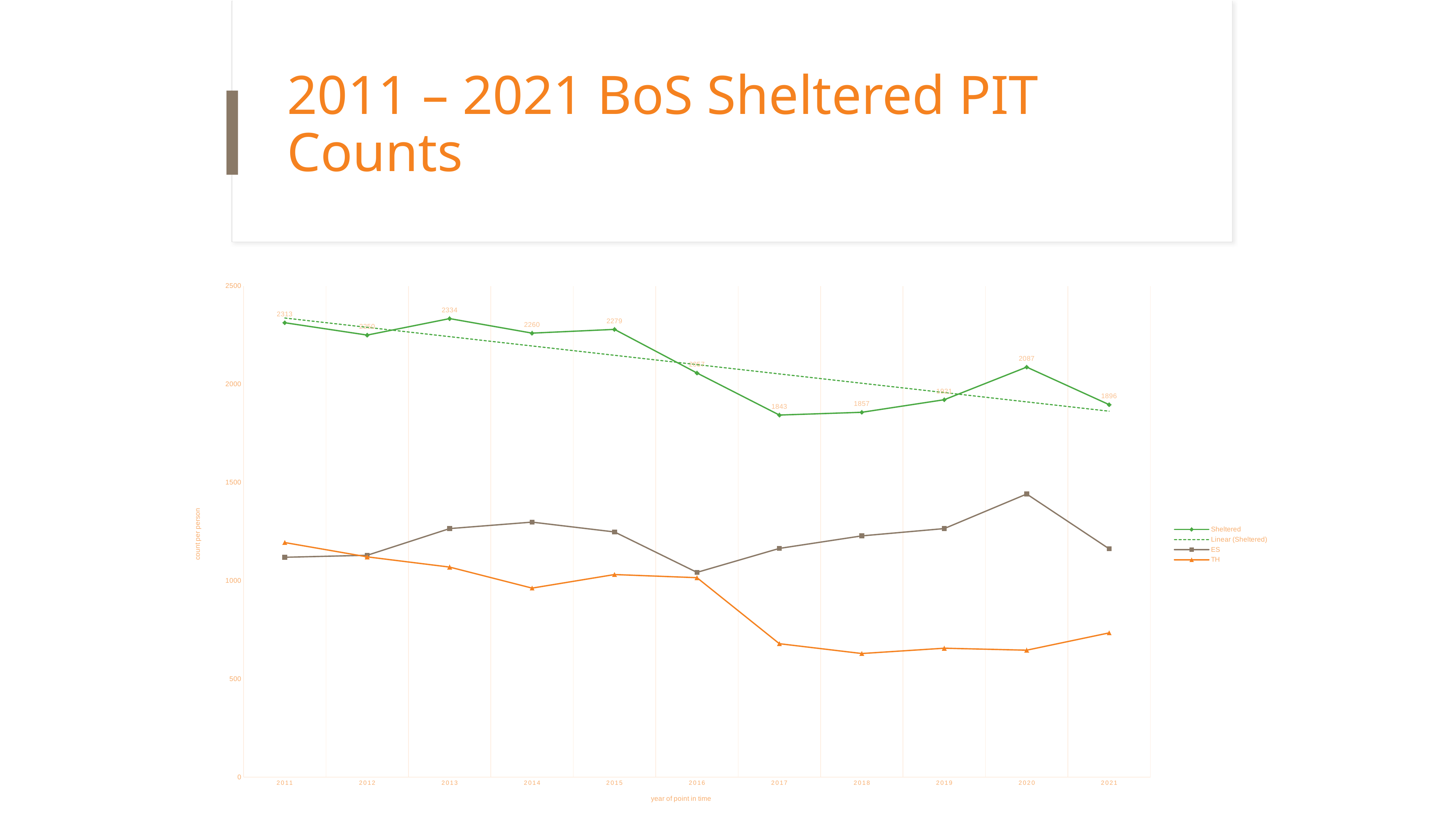
What kind of chart is shown on the slide? line chart How many series does the legend list? 4 How many years are plotted along the x axis? 11 Does the Linear (Sheltered) trendline rise or fall from 2011 to 2021? fall What is the Sheltered count for 2011? 2313 What is the Sheltered count for 2020? 2087 In which year is the Sheltered count highest? 2013 What is the difference between the Sheltered counts for 2020 and 2021? 191 What is the Sheltered count for 2017? 1843 What is the Sheltered count for 2013? 2334 In which year is the Sheltered count lowest? 2017 Is the TH value for 2018 greater or less than 1000? less